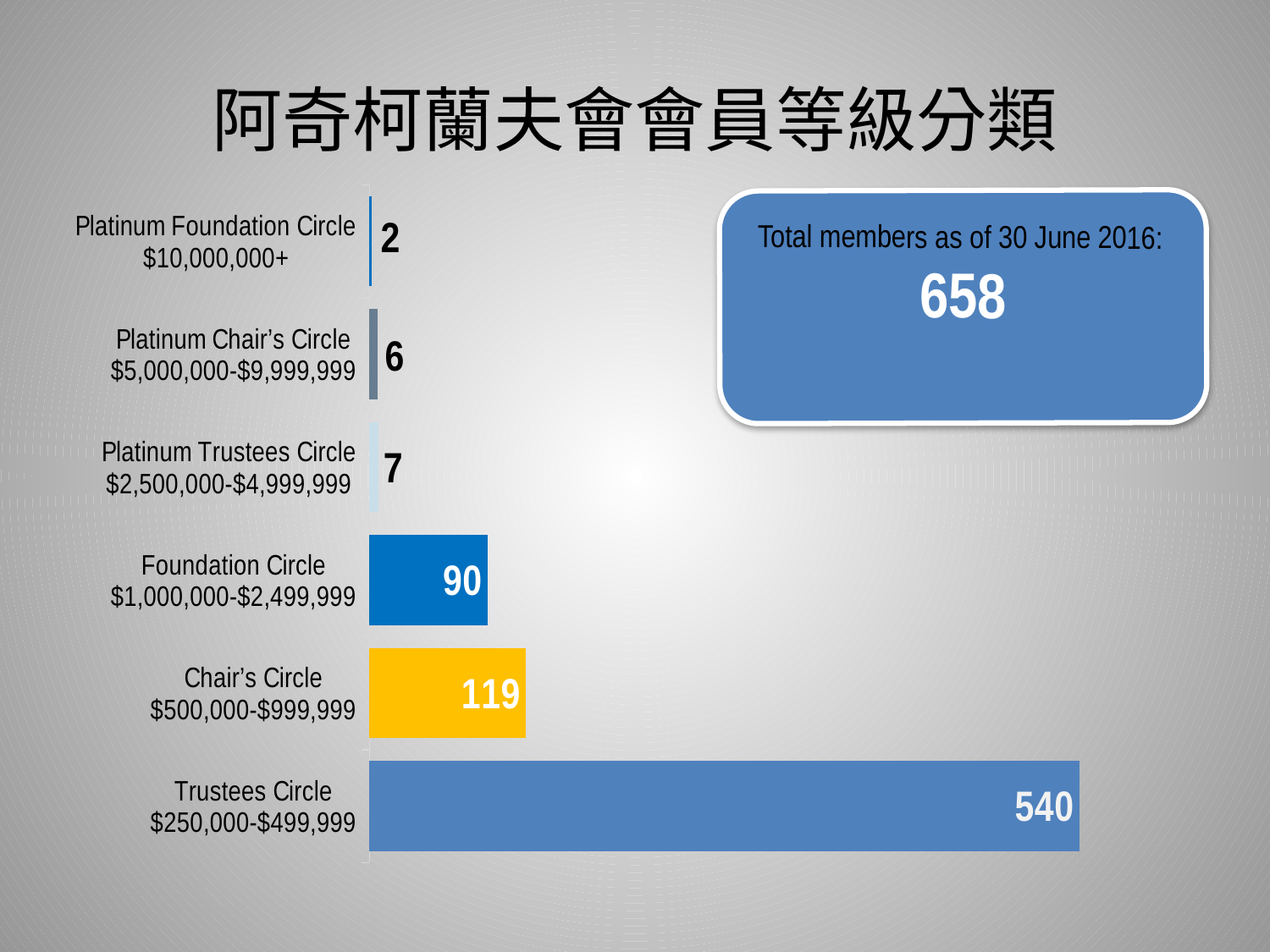
What is the value for Chair's Circle? 119 What is the value for Platinum Trustees Circle? 7 What is the value for Platinum Foundation Circle? 2 What is the difference between the values for Trustees Circle and Chair's Circle? 421 What is the value for Trustees Circle? 540 Which category has the lowest value? Platinum Foundation Circle How many categories are shown in the chart? 6 What total number of members as of 30 June 2016 is shown in the box on the slide? 658 Which is larger, the value for Chair's Circle or the value for Foundation Circle? Chair's Circle What kind of chart is shown on the slide? bar chart What is the value for Foundation Circle? 90 Which category has the highest value? Trustees Circle